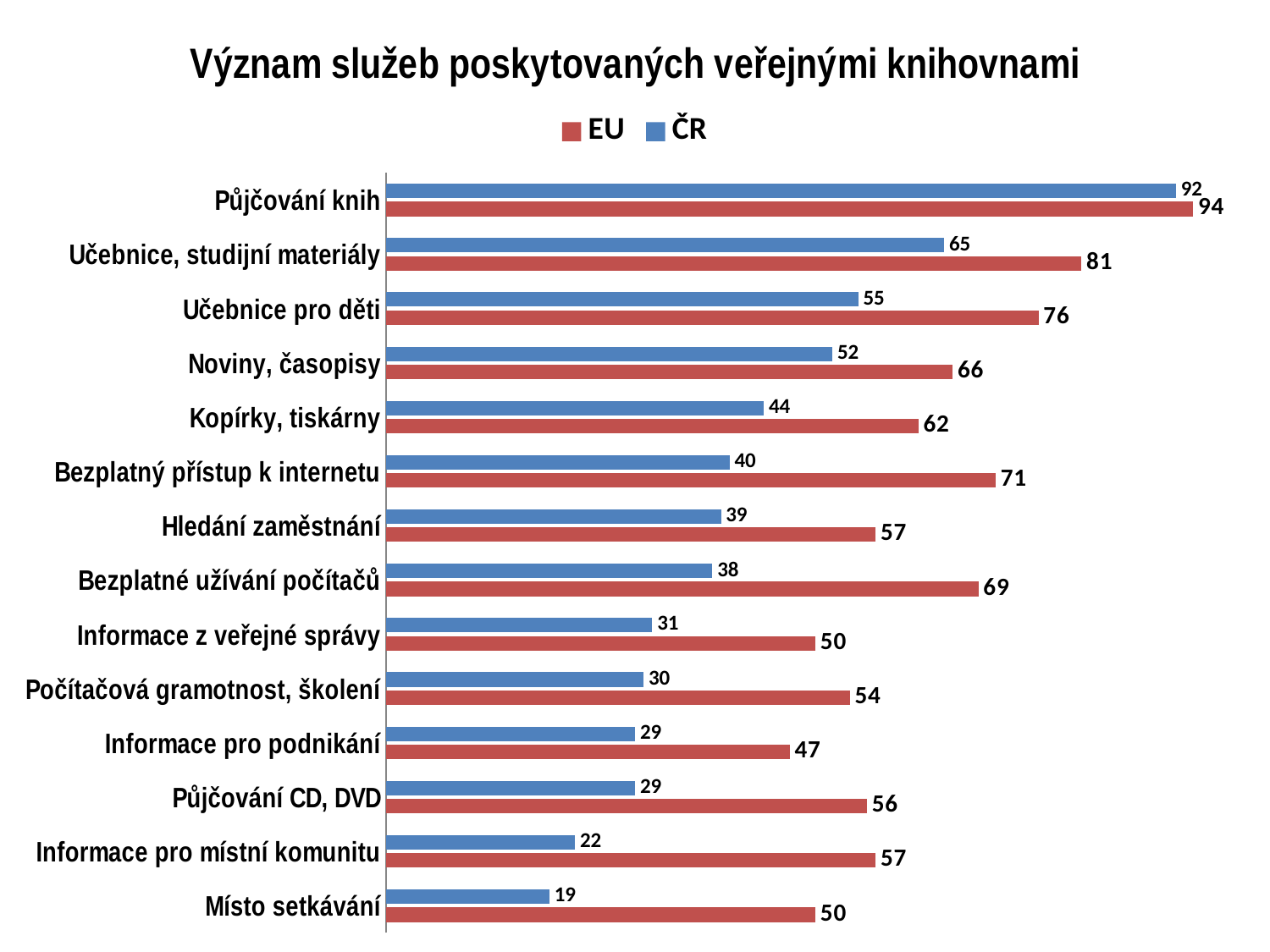
What is the EU value for Místo setkávání? 50 What is the title of the chart? Význam služeb poskytovaných veřejnými knihovnami Which colour represents the ČR series? Blue What is the EU value for Bezplatný přístup k internetu? 71 What is the ČR value for Půjčování knih? 92 How many categories are shown on the chart? 14 How many series does the legend list? 2 Which category has the lowest ČR value? Místo setkávání Which is larger for Bezplatné užívání počítačů, the EU value or the ČR value? EU Which category has the highest EU value? Půjčování knih What is the difference between the EU and ČR values for Učebnice pro děti? 21 What kind of chart is shown on the slide? Bar chart